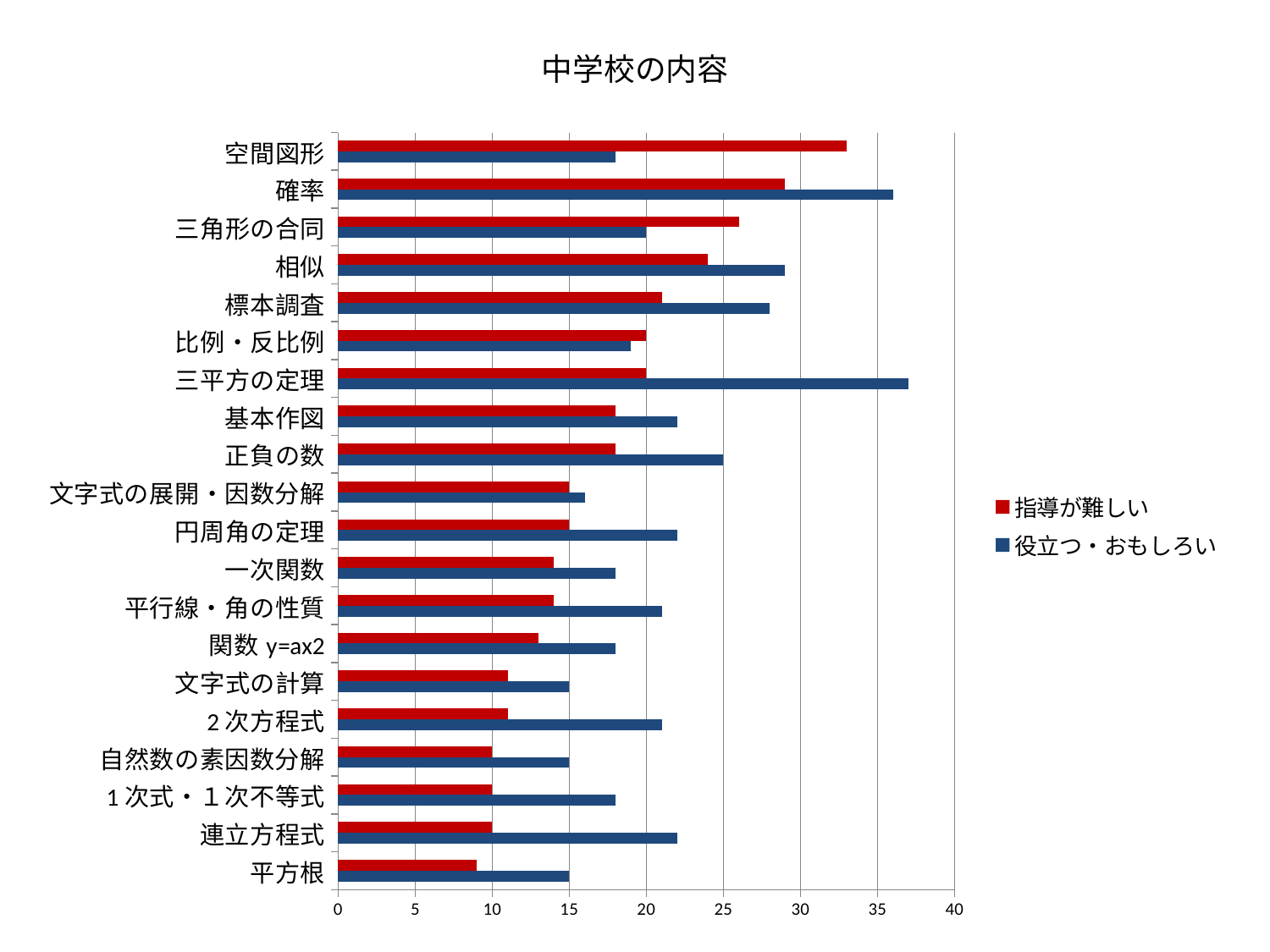
Is the 役立つ・おもしろい value for 連立方程式 greater or less than 20? greater How many series does the legend list? 2 Is the 指導が難しい value for 空間図形 greater or less than 30? greater How many categories are plotted on the chart? 20 Is the 指導が難しい value for 関数 y=ax2 greater or less than 15? less Which category has the highest value for 指導が難しい? 空間図形 For 空間図形, which series has the larger value, 指導が難しい or 役立つ・おもしろい? 指導が難しい For 確率, which series has the larger value, 指導が難しい or 役立つ・おもしろい? 役立つ・おもしろい What is the title of the chart? 中学校の内容 What kind of chart is shown on the slide? bar chart